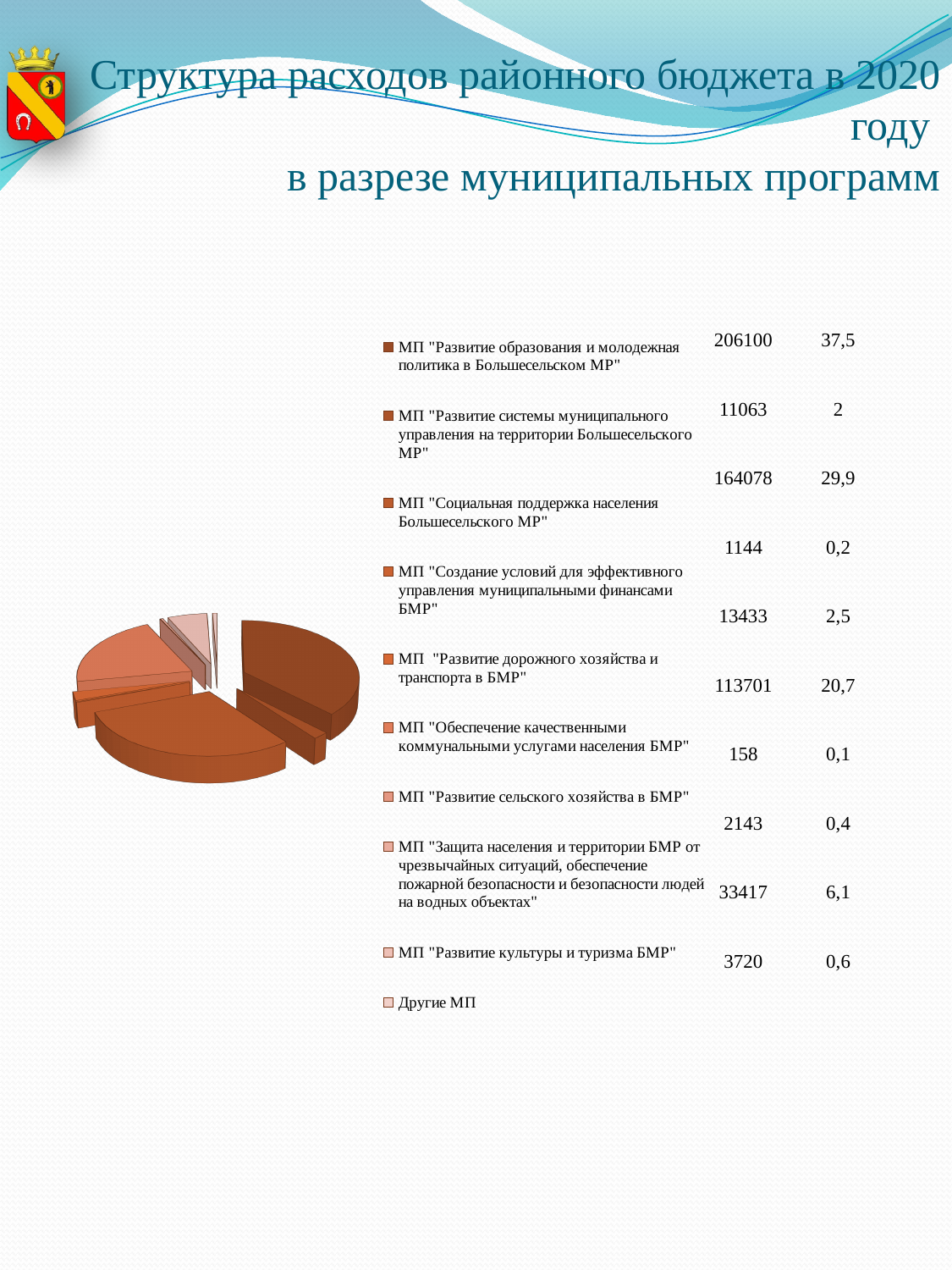
Which is larger: the expenditure for МП "Социальная поддержка населения Большесельского МР" or for МП "Обеспечение качественными коммунальными услугами населения БМР"? МП "Социальная поддержка населения Большесельского МР" Which program has the smallest share of expenditures in the pie chart? МП "Развитие сельского хозяйства в БМР" What is the expenditure value printed for МП "Развитие образования и молодежная политика в Большесельском МР"? 206100 What share of expenditures does МП "Социальная поддержка населения Большесельского МР" account for? 29,9 What kind of chart is shown on the slide? pie chart What is the expenditure value printed for МП "Развитие системы муниципального управления на территории Большесельского МР"? 11063 What is the title of the slide containing the pie chart? Структура расходов районного бюджета в 2020 году в разрезе муниципальных программ What share of expenditures does МП "Развитие образования и молодежная политика в Большесельском МР" account for? 37,5 How many entries does the legend of the pie chart list? 10 What is the difference between the expenditure values for МП "Развитие образования и молодежная политика в Большесельском МР" and МП "Социальная поддержка населения Большесельского МР"? 42022 What share of expenditures does МП "Обеспечение качественными коммунальными услугами населения БМР" account for? 20,7 Which program has the largest share of the district budget expenditures in the pie chart? МП "Развитие образования и молодежная политика в Большесельском МР"